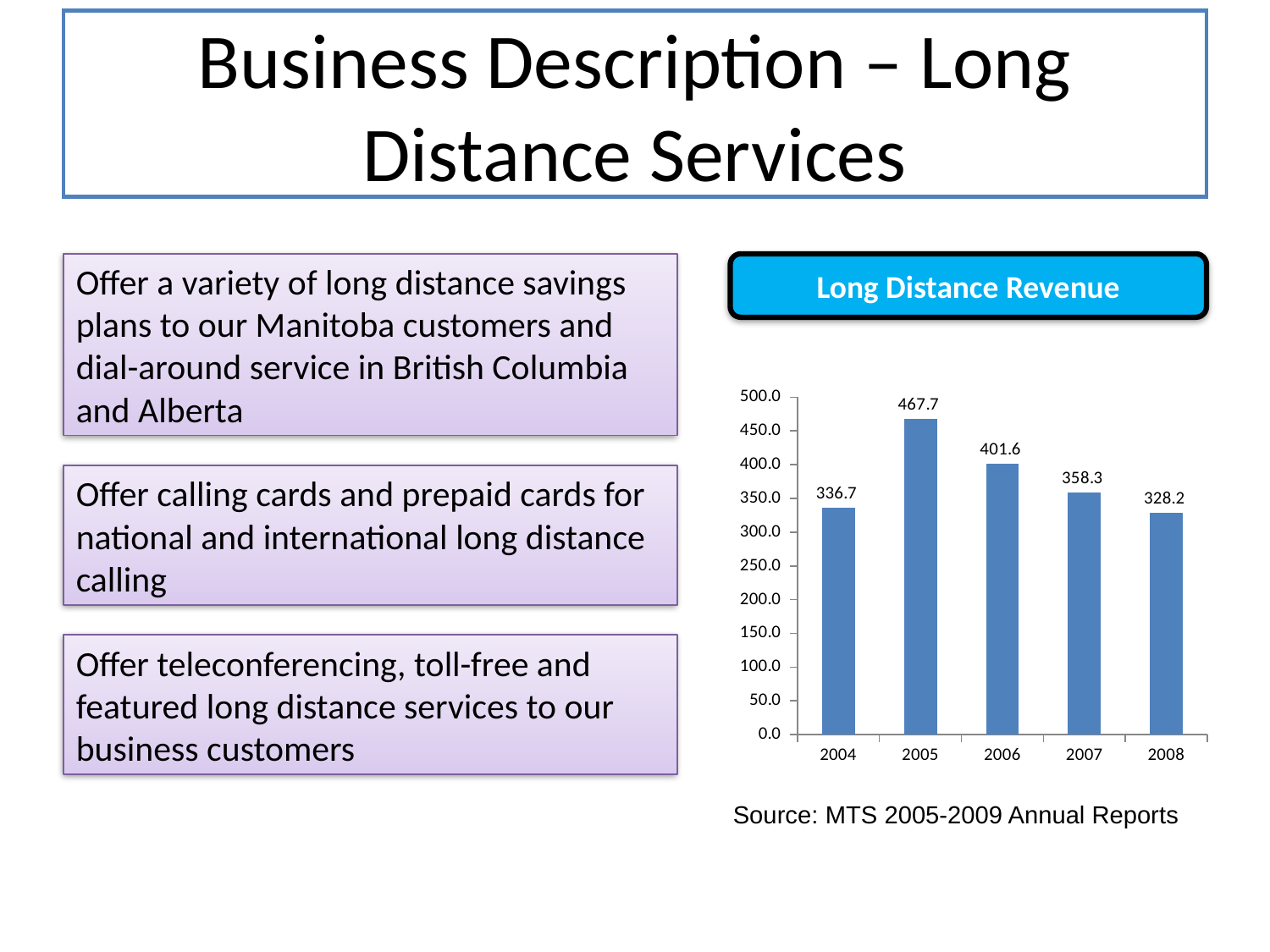
What is the Long Distance Revenue value for 2004? 336.7 What kind of chart is used to show Long Distance Revenue? bar chart What is the difference between the Long Distance Revenue in 2004 and 2008? 8.5 Which year has the lowest Long Distance Revenue? 2008 What is the Long Distance Revenue value for 2005? 467.7 Is the Long Distance Revenue for 2007 greater or less than 400.0? less Does the Long Distance Revenue rise or fall from 2005 to 2008? fall What is the difference between the Long Distance Revenue in 2005 and 2006? 66.1 What is the Long Distance Revenue value for 2008? 328.2 Which year has the highest Long Distance Revenue? 2005 Which year has a larger Long Distance Revenue, 2006 or 2007? 2006 How many years are shown in the Long Distance Revenue chart? 5